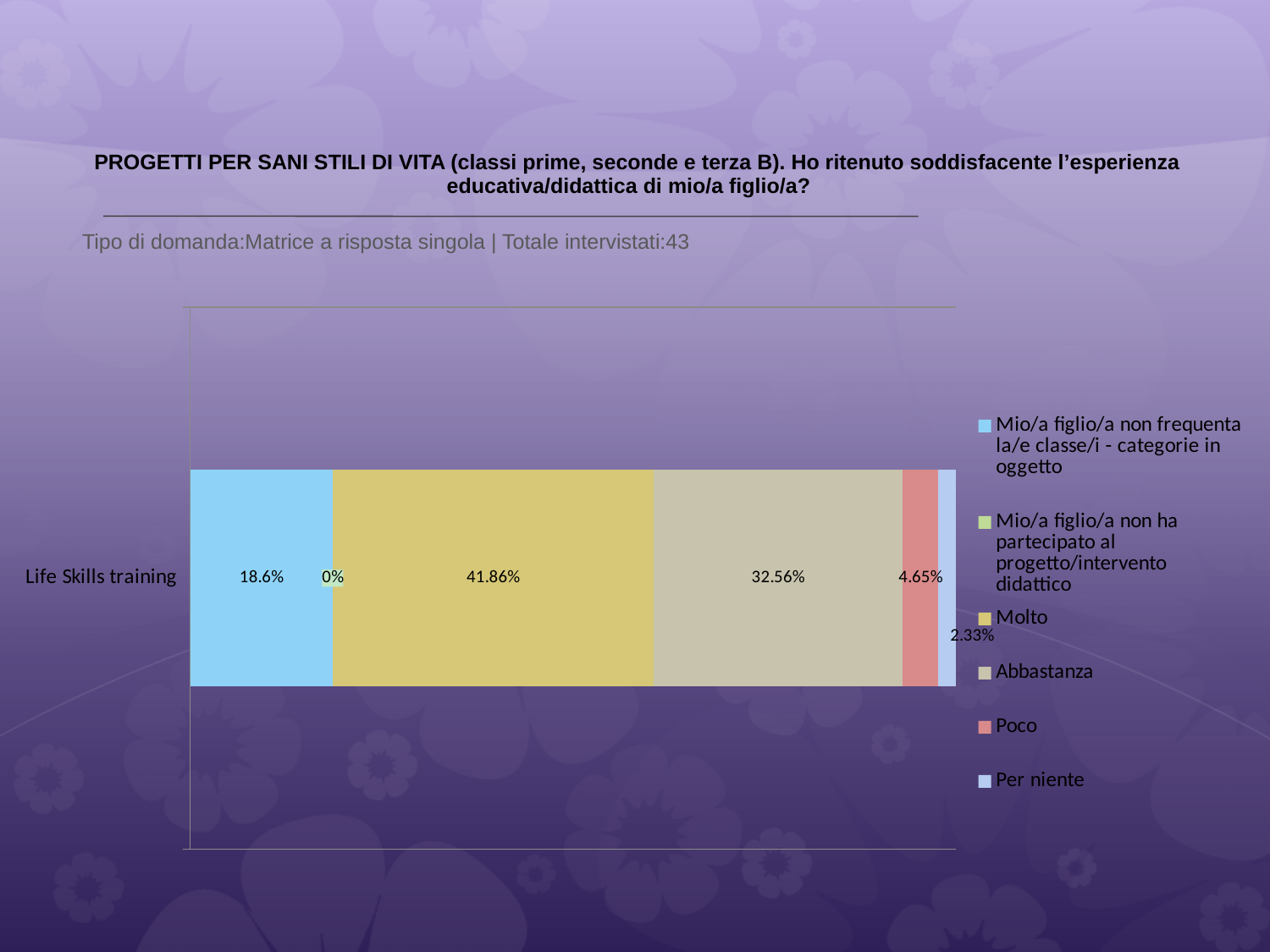
Which series has the lowest value for Life Skills training? Mio/a figlio/a non ha partecipato al progetto/intervento didattico Which series has the highest value for Life Skills training? Molto What kind of chart is shown on the slide? Stacked bar chart What is the difference between the "Molto" and "Abbastanza" values for Life Skills training? 9.3% What is the value for "Poco" for Life Skills training? 4.65% How many categories are plotted on the chart? 1 What is the value for "Abbastanza" for Life Skills training? 32.56% What is the value for "Per niente" for Life Skills training? 2.33% Which is larger for Life Skills training, "Poco" or "Per niente"? Poco How many series does the legend list? 6 What is the value for "Molto" for Life Skills training? 41.86% What is the value for "Mio/a figlio/a non ha partecipato al progetto/intervento didattico" for Life Skills training? 0%